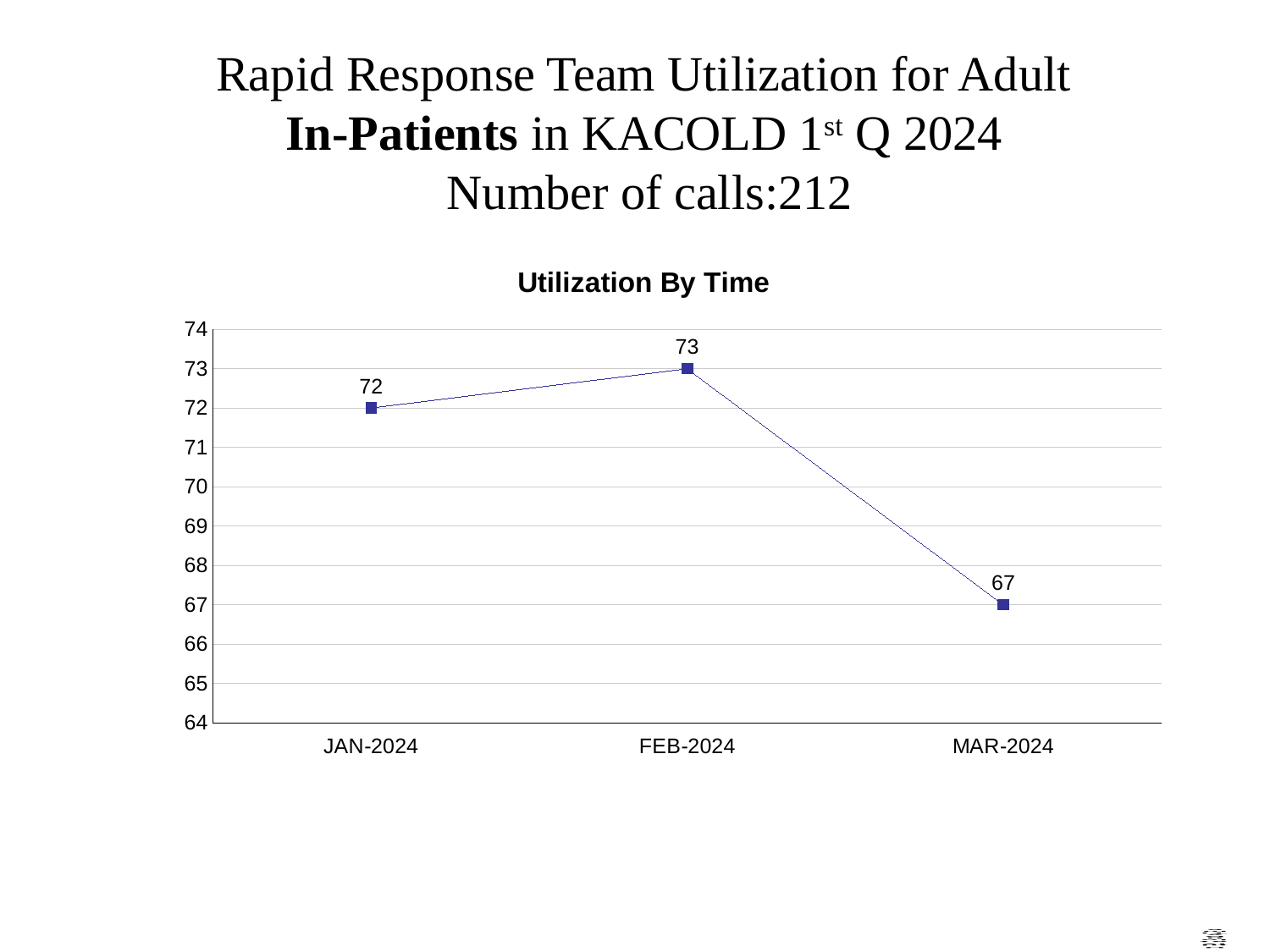
Which month has the highest value? FEB-2024 What is the value for MAR-2024? 67 What is the difference between the values for FEB-2024 and MAR-2024? 6 What kind of chart is shown? line chart How many months are plotted on the chart? 3 What is the difference between the values for JAN-2024 and MAR-2024? 5 Which month has the lowest value? MAR-2024 What is the title of the chart? Utilization By Time What is the value for JAN-2024? 72 What is the value for FEB-2024? 73 Which is larger, the value for JAN-2024 or the value for MAR-2024? JAN-2024 Is the value for MAR-2024 greater or less than 70? less